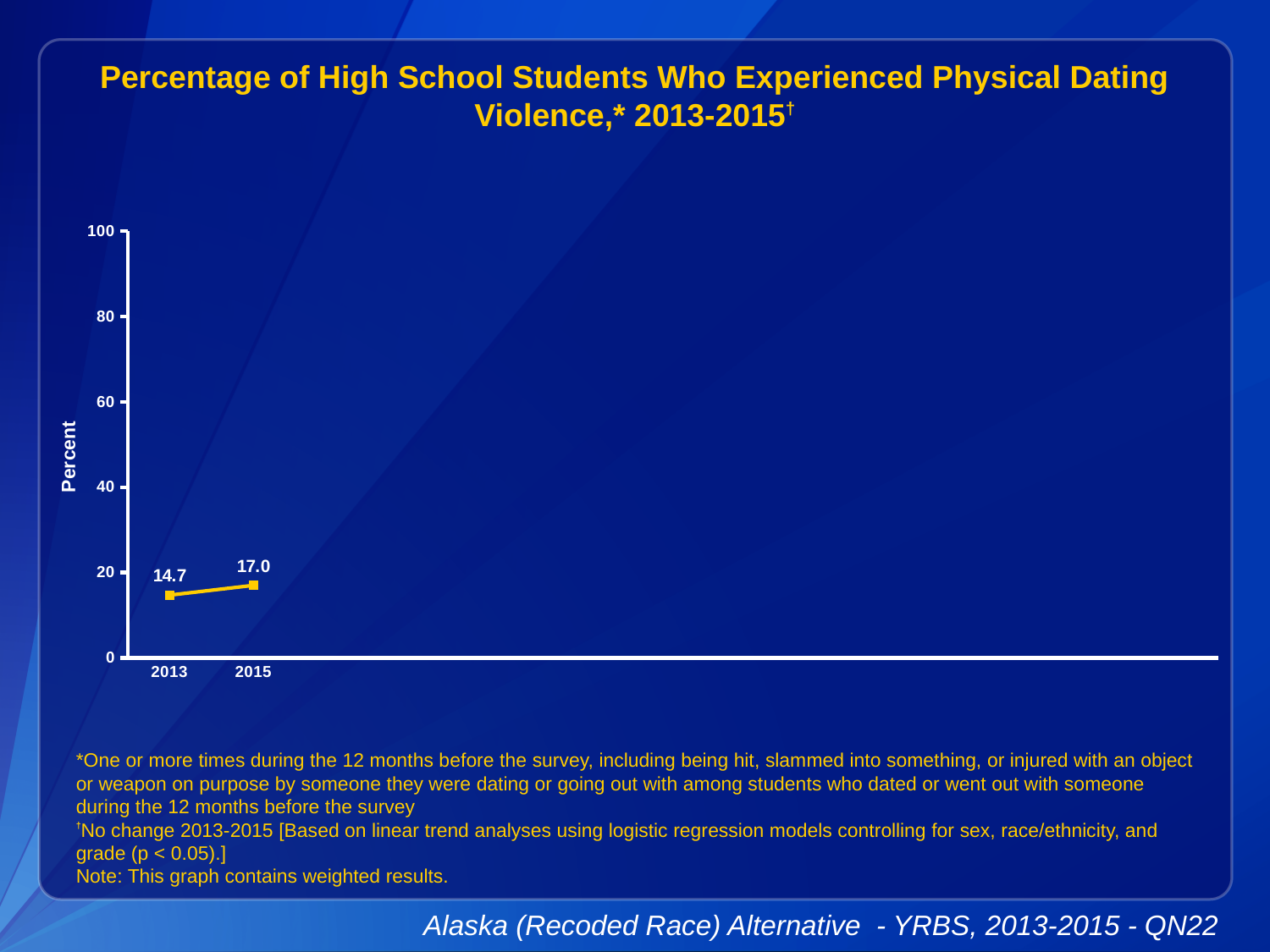
What is the maximum value shown on the y axis? 100 What is the label on the y axis? Percent Which year has the lower value? 2013 How many data points are plotted? 2 What is the value for 2013? 14.7 Which year has the higher value? 2015 Is the value for 2015 larger than the value for 2013? Yes Is the value for 2013 greater or less than 20? less Do the values rise or fall from 2013 to 2015? Rise What is the value for 2015? 17.0 What kind of chart is this? Line chart What is the difference between the 2015 and 2013 values? 2.3